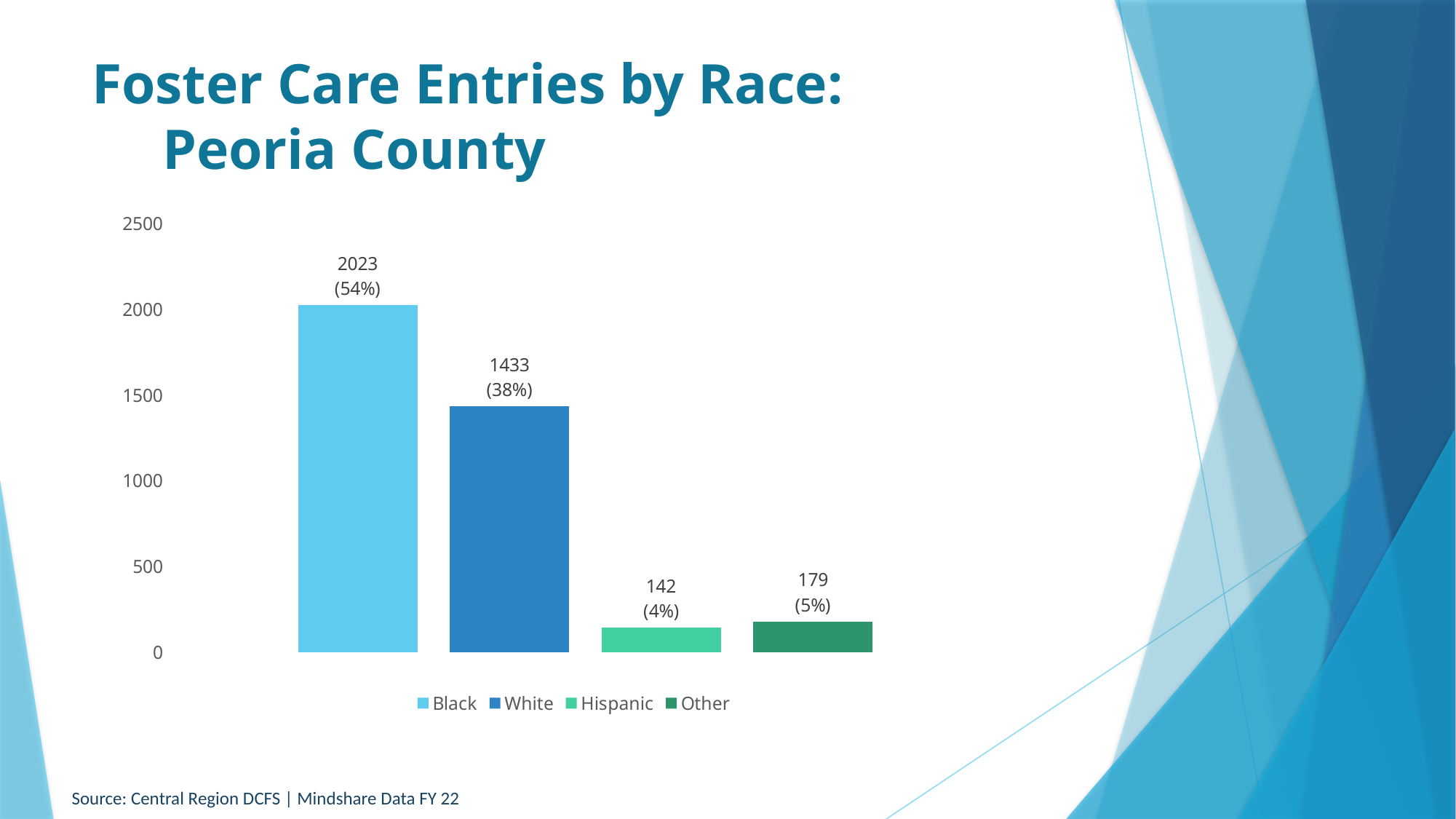
Which has more foster care entries, Hispanic or Other? Other What is the number of foster care entries for Hispanic children? 142 Which race category has the highest number of foster care entries? Black Is the value for White greater or less than 1500? less What is the difference between the Black and White foster care entries? 590 What percentage of foster care entries is shown for the Other category? 5% How many race categories are shown in the chart? 4 Which race category has the lowest number of foster care entries? Hispanic What is the source cited for the chart data? Central Region DCFS | Mindshare Data FY 22 What type of chart is shown on the slide? Bar chart What is the number of foster care entries for White children? 1433 What is the number of foster care entries for Black children in Peoria County? 2023